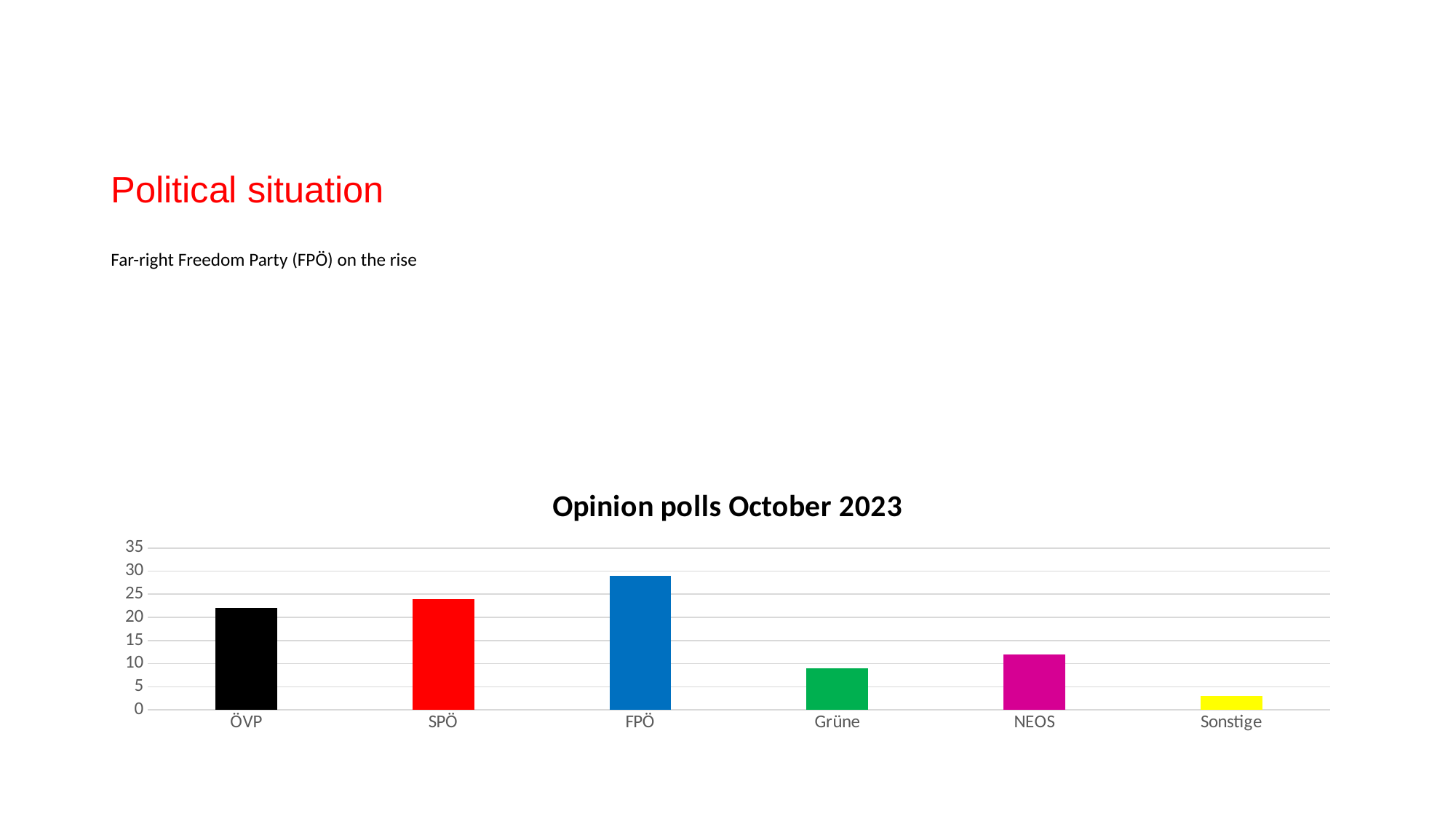
Which has a larger value, NEOS or Grüne? NEOS How many parties (categories) are shown in the chart? 6 What type of chart is shown on the slide? bar chart Which category has the lowest value in the chart? Sonstige What is the title of the chart? Opinion polls October 2023 Is the value for NEOS greater or less than 15? less Is the value for Grüne greater or less than 5? greater Is the value for Sonstige greater or less than 5? less Which has a larger value, FPÖ or SPÖ? FPÖ What colour is the bar for FPÖ? blue Which party has the highest value in the chart? FPÖ